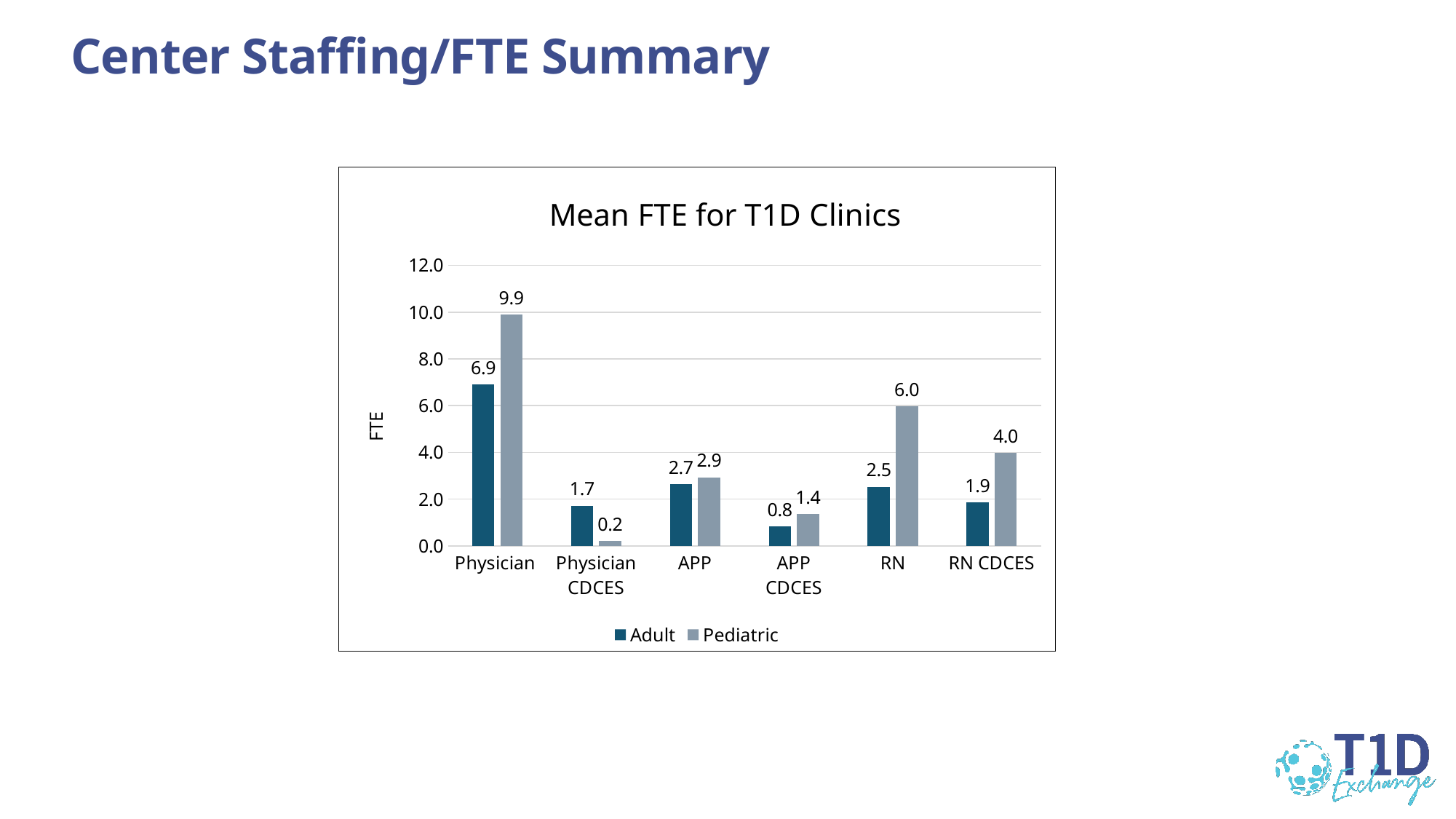
What is the mean FTE for Pediatric Physician CDCES? 0.2 What is the difference between the Adult and Pediatric FTE for Physician CDCES? 1.5 What kind of chart is shown? Bar chart What is the difference between the Pediatric and Adult FTE for RN? 3.5 How many staffing categories are shown on the x axis? 6 Which category has the lowest Adult FTE? APP CDCES What is the title of the chart? Mean FTE for T1D Clinics What is the mean FTE for Adult Physician? 6.9 Which category has the highest Pediatric FTE? Physician What is the mean FTE for Pediatric RN? 6.0 Which is larger for RN CDCES, the Adult or the Pediatric FTE? Pediatric How many series does the legend list? 2